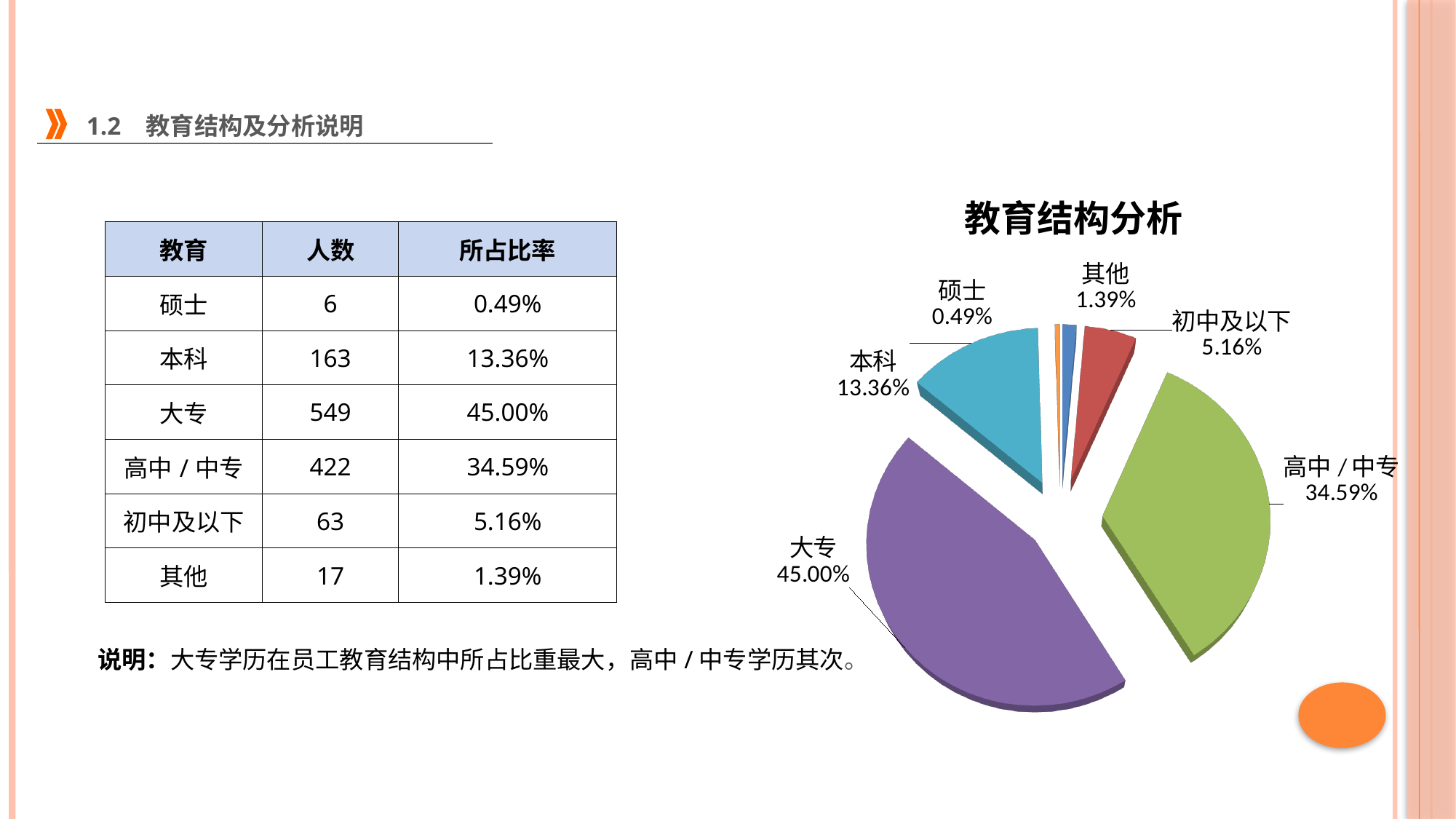
Which category has the largest slice in the pie chart? 大专 What is the value shown for 本科 in the pie chart? 13.36% What is the title of the chart? 教育结构分析 What is the difference in percentage points between 大专 and 高中 / 中专? 10.41% What is the value shown for 其他 in the pie chart? 1.39% Which category has the smallest slice in the pie chart? 硕士 What colour is the 大专 slice in the pie chart? Purple What type of chart is shown on the slide? Pie chart Which is larger in the pie chart, 本科 or 初中及以下? 本科 How many slices does the pie chart have? 6 What is the value shown for 初中及以下 in the pie chart? 5.16% What share of the pie does 大专 represent? 45.00%